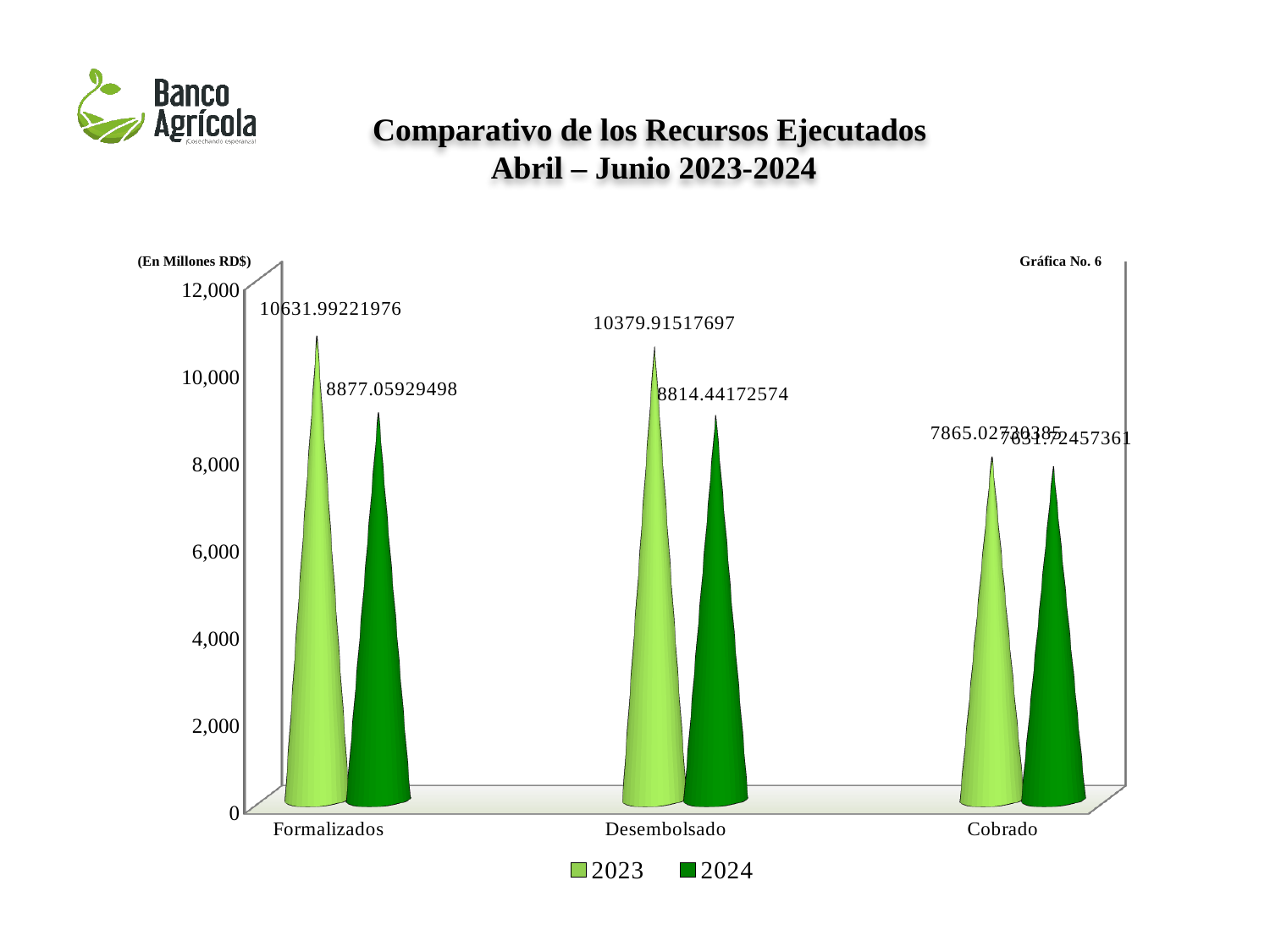
What is the value for Formalizados in 2024? 8877.05929498 How many categories are shown on the x axis? 3 What is the value for Formalizados in 2023? 10631.99221976 Which category has the lowest value for 2024? Cobrado Which category has the highest value for 2023? Formalizados What is the difference between the 2023 and 2024 values for Formalizados? 1754.93292478 Is the 2023 value for Cobrado greater or less than 6,000? greater How many series does the legend list? 2 What is the value for Desembolsado in 2024? 8814.44172574 What is the value for Desembolsado in 2023? 10379.91517697 Do the 2024 values rise or fall from Formalizados to Cobrado? Fall What kind of chart is shown on the slide? Bar chart